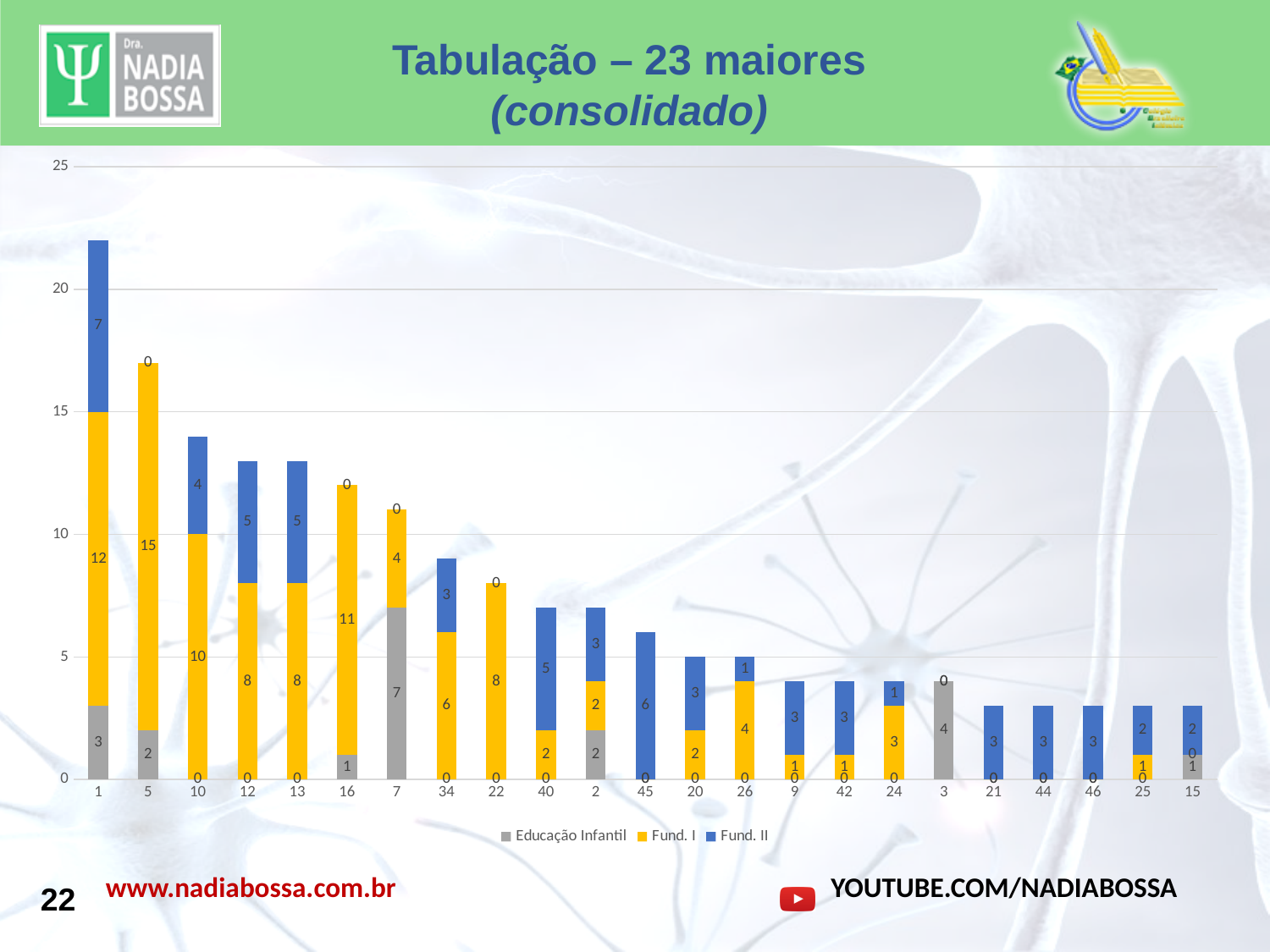
What is the difference between the Fund. I values for category 16 and category 34? 5 What is the Educação Infantil value for category 7? 7 What is the Fund. II value for category 45? 6 What kind of chart is shown on the slide? Stacked bar chart Which category has the tallest stacked bar? 1 What is the total of the stacked bar for category 10? 14 How many categories are shown on the x axis? 23 What is the Fund. I value for category 5? 15 What is the total of the stacked bar for category 1? 22 How many series does the legend list? 3 Which series is shown in yellow in the legend? Fund. I Which is larger, the Fund. II value for category 1 or the Fund. II value for category 12? Category 1